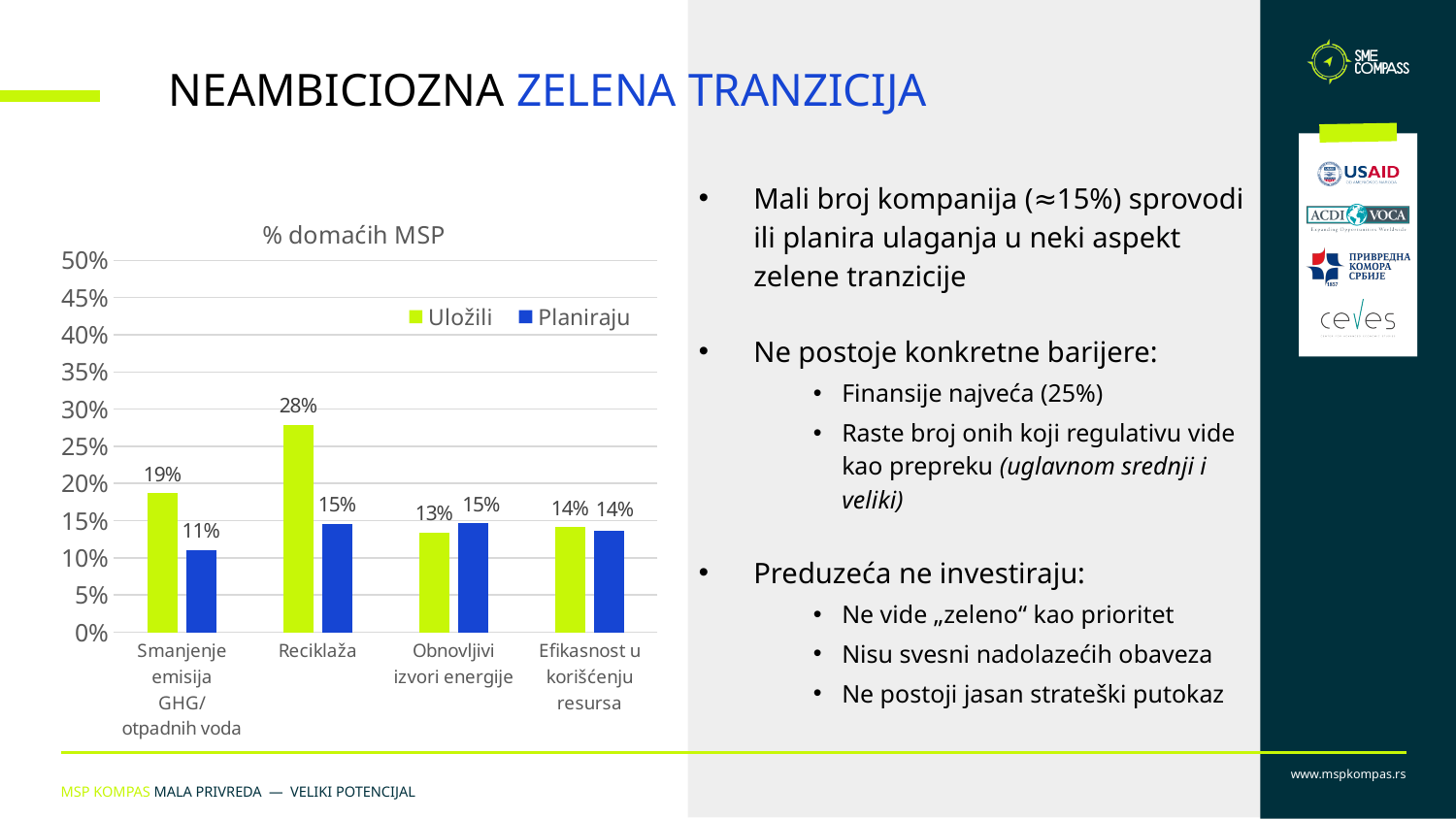
How many categories are shown on the x axis? 4 How many series does the legend list? 2 Which category has the lowest Planiraju value? Smanjenje emisija GHG/otpadnih voda What is the value for Uložili in the Obnovljivi izvori energije category? 13% What is the value for Planiraju in the Smanjenje emisija GHG/otpadnih voda category? 11% What is the difference between the Uložili and Planiraju values for Reciklaža? 13% Is the Uložili value for Reciklaža greater or less than 25%? greater What is the value for Uložili in the Reciklaža category? 28% Which category has the highest Uložili value? Reciklaža What kind of chart is shown on the slide? bar chart What is the title of the chart? % domaćih MSP Which is larger for Obnovljivi izvori energije: Uložili or Planiraju? Planiraju